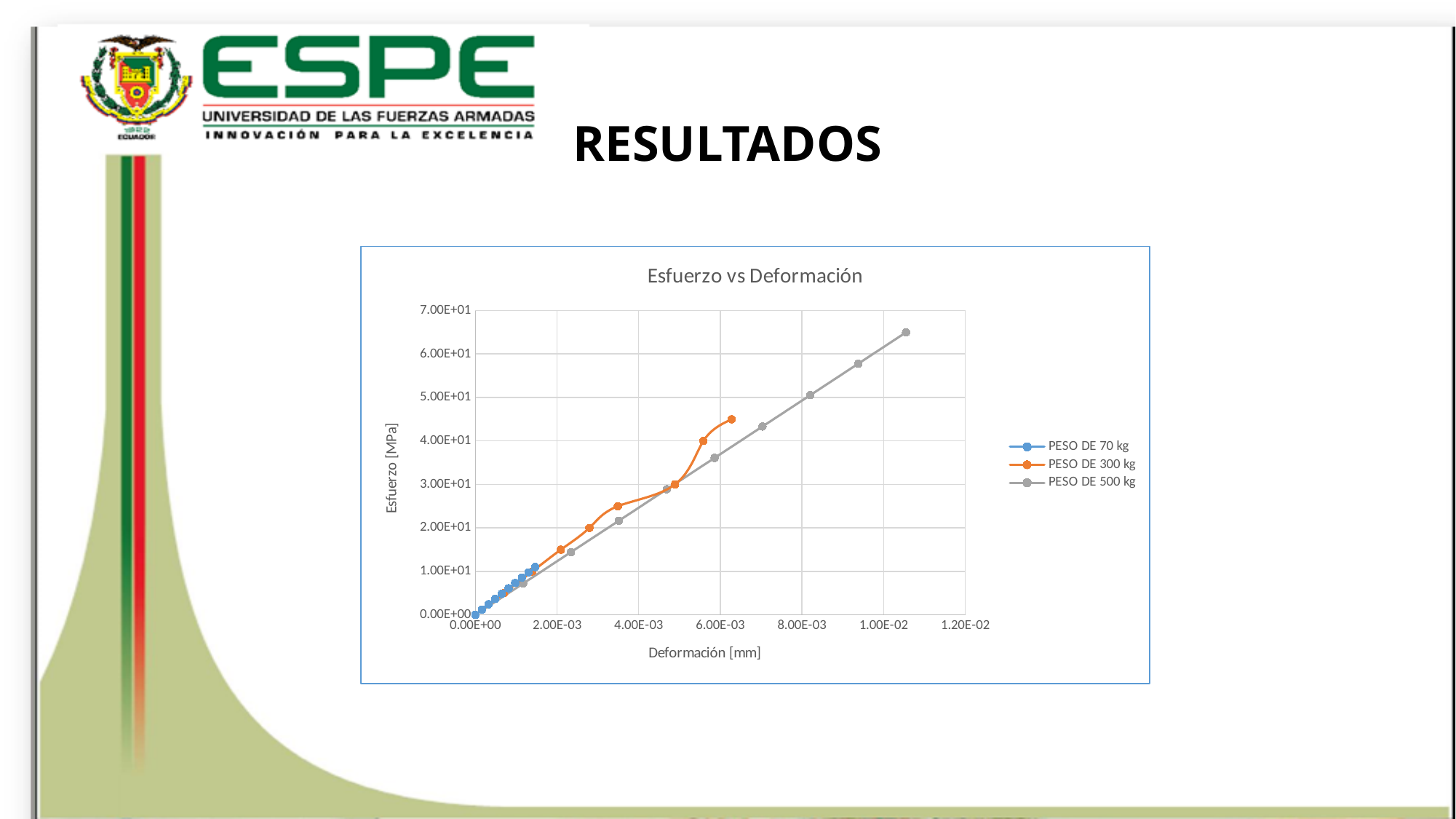
Which series extends to a larger deformation value, PESO DE 300 kg or PESO DE 500 kg? PESO DE 500 kg What type of chart is shown on the slide? Line chart with markers Is the highest stress value of the PESO DE 500 kg series greater or less than 6.00E+01? greater Is the highest stress value of the PESO DE 70 kg series greater or less than 2.00E+01? less Which series reaches the lowest maximum stress value in the chart? PESO DE 70 kg What is the title of the chart? Esfuerzo vs Deformación What is the label of the vertical axis of the chart? Esfuerzo [MPa] Is the highest stress value of the PESO DE 300 kg series greater or less than 4.00E+01? greater Do the values of the PESO DE 500 kg series rise or fall as deformation increases along the x axis? Rise How many series does the legend of the chart list? 3 Which series reaches the highest stress (Esfuerzo) value in the chart? PESO DE 500 kg